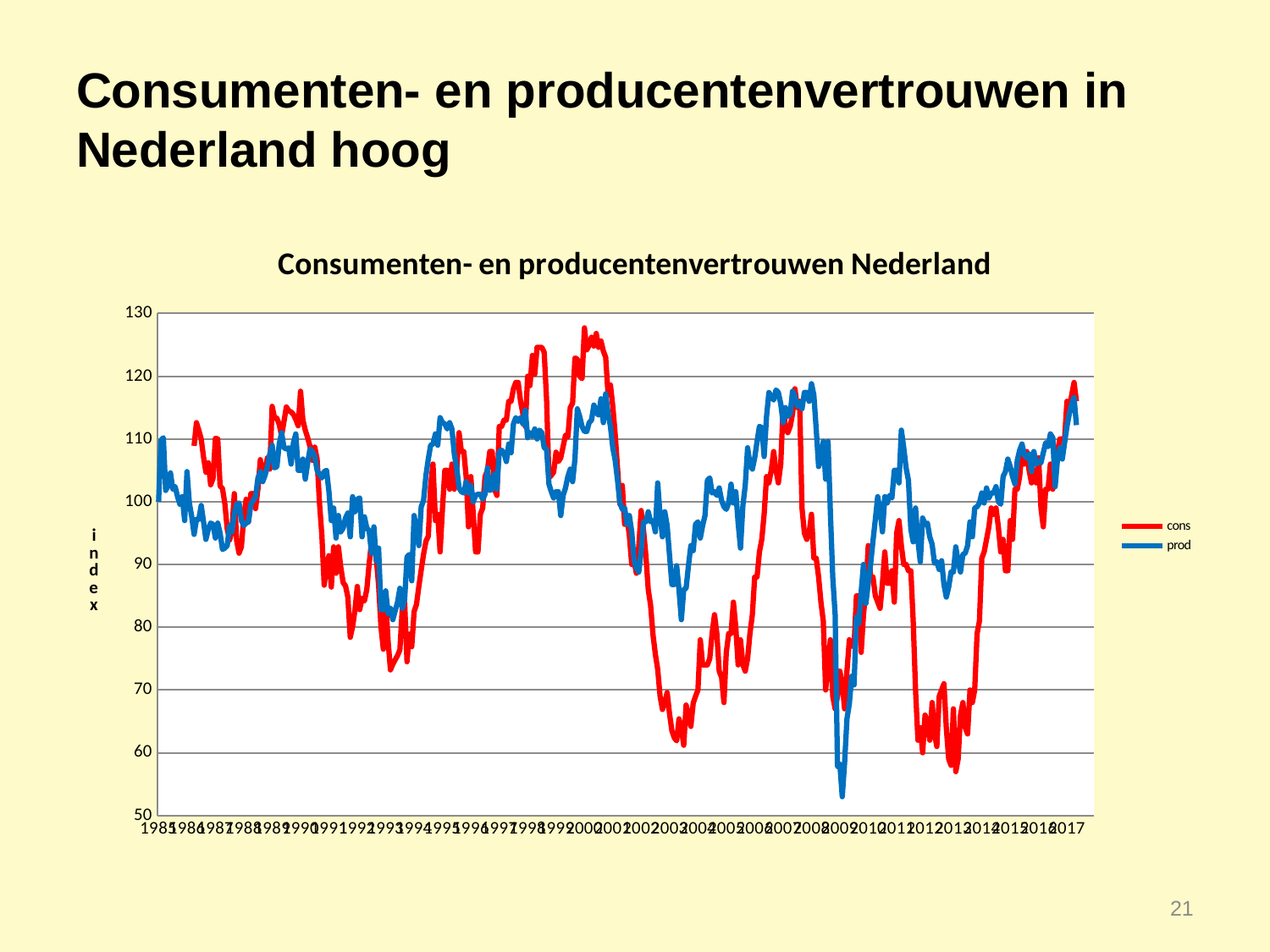
Is the lowest value of the 'prod' series (around 2009) greater or less than 60? less What is the title of the chart? Consumenten- en producentenvertrouwen Nederland Is the highest value of the 'cons' series (around 2000) greater or less than 120? greater What kind of chart is shown on the slide? line chart Is the lowest value of the 'cons' series around 1993 greater or less than 80? less Does the 'cons' series rise or fall between 2000 and 2003? fall How many series does the legend list? 2 Which colour is used for the 'cons' series? red Does the 'cons' series rise or fall between 2013 and 2017? rise Which series reaches the higher peak value over the whole period, 'cons' or 'prod'? cons